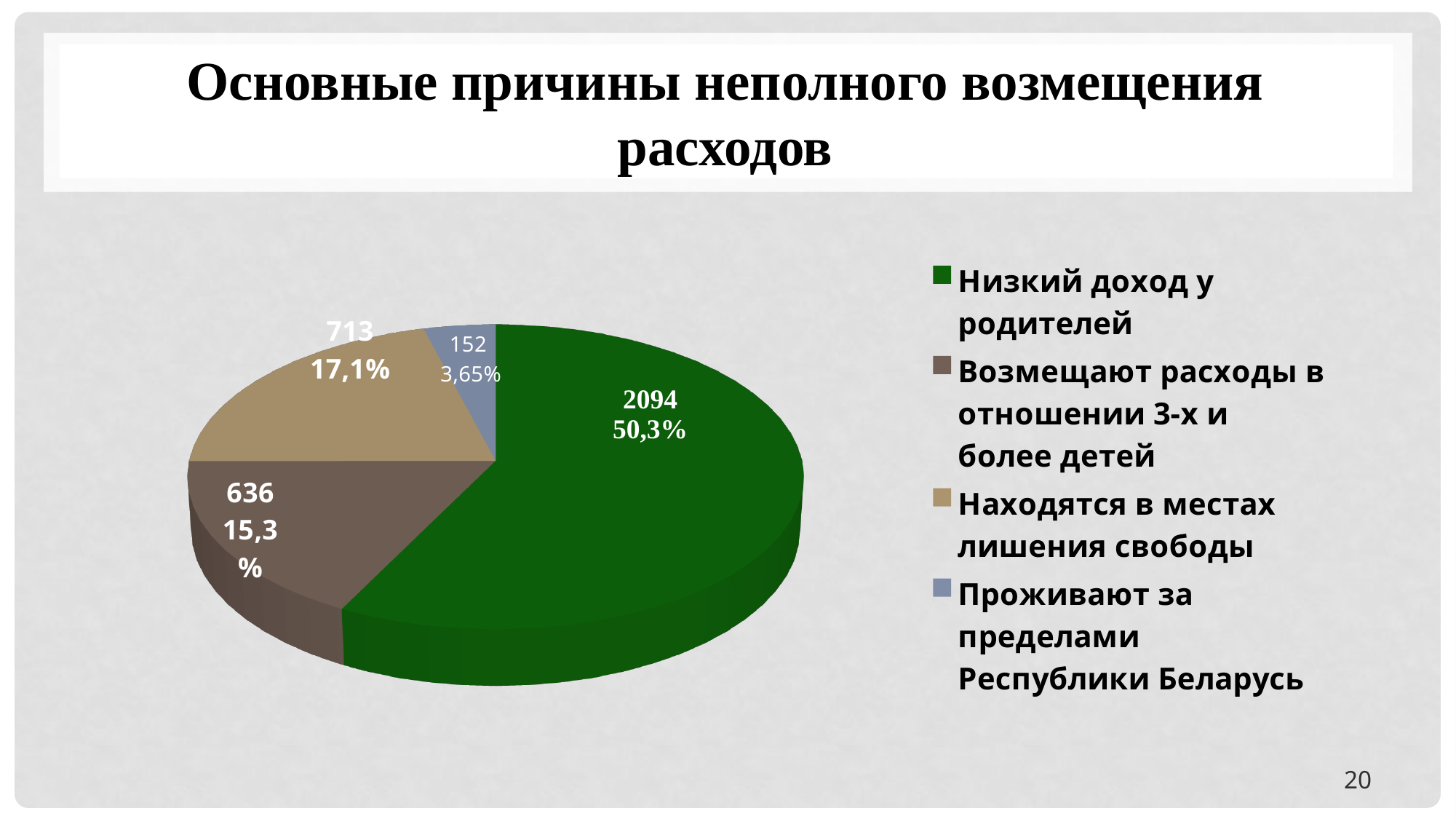
Which category has the largest slice in the pie chart? Низкий доход у родителей What is the difference between the values for 'Находятся в местах лишения свободы' and 'Возмещают расходы в отношении 3-х и более детей'? 77 What kind of chart is shown on the slide? Pie chart What value is shown for the slice 'Находятся в местах лишения свободы'? 713 What percentage is shown for the slice 'Низкий доход у родителей'? 50,3% What colour is the slice for 'Низкий доход у родителей'? Green What value is shown for the slice 'Проживают за пределами Республики Беларусь'? 152 Which category has the smallest slice in the pie chart? Проживают за пределами Республики Беларусь Which is larger: the value for 'Находятся в местах лишения свободы' or the value for 'Возмещают расходы в отношении 3-х и более детей'? Находятся в местах лишения свободы What percentage is shown for the slice 'Возмещают расходы в отношении 3-х и более детей'? 15,3% How many slices does the pie chart have? 4 What value is shown for the slice 'Низкий доход у родителей'? 2094